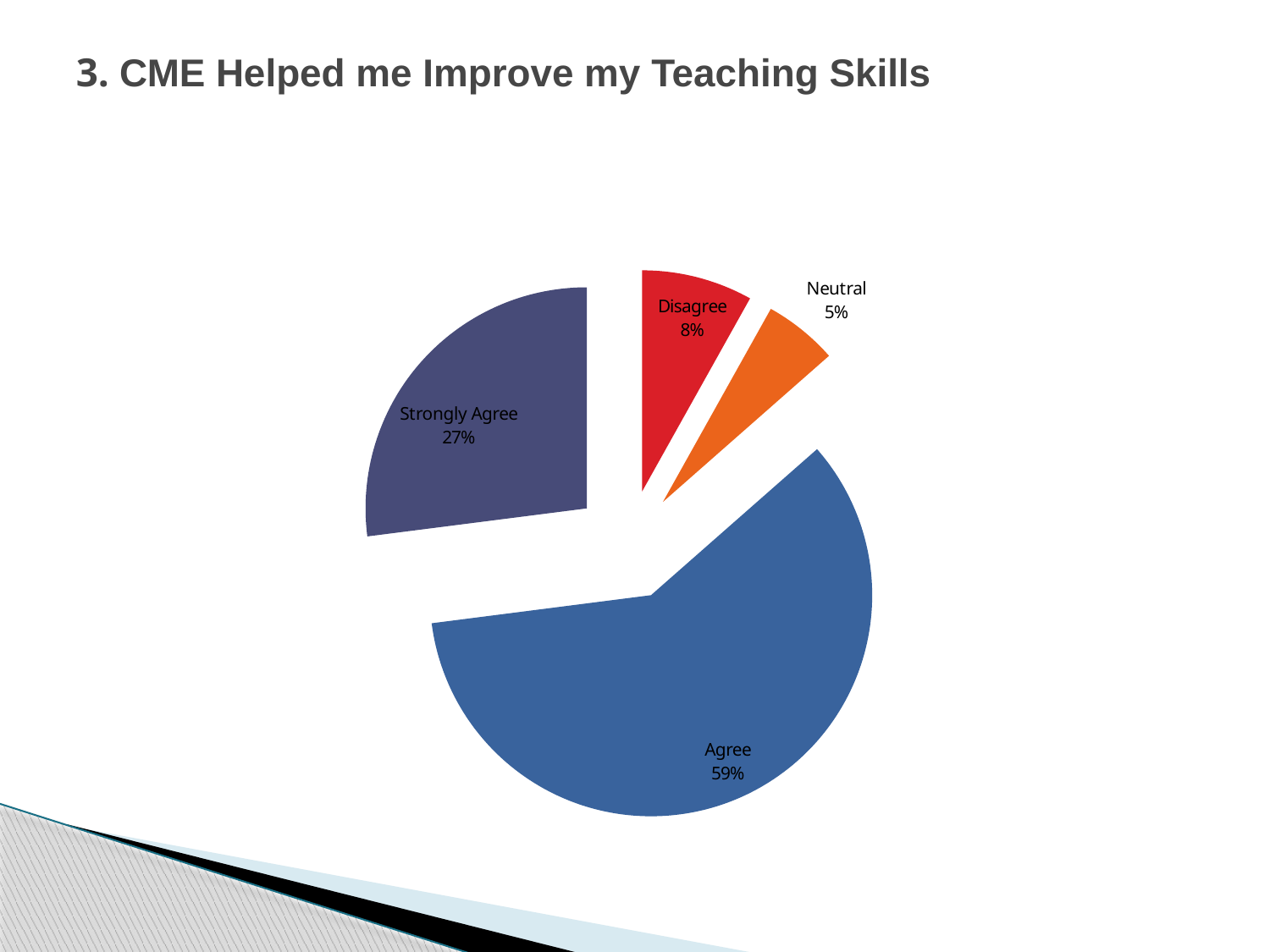
What is the difference in percentage points between Agree and Strongly Agree? 32 How many slices does the pie chart have? 4 What percentage of respondents chose Strongly Agree? 27% What percentage of respondents chose Disagree? 8% What kind of chart is shown on the slide? pie chart Which response category has the smallest share of the pie? Neutral Which response category has the largest share of the pie? Agree What percentage of respondents chose Agree? 59% What is the title of the slide containing the pie chart? 3. CME Helped me Improve my Teaching Skills What is the combined share of Agree and Strongly Agree? 86% What percentage of respondents chose Neutral? 5% Which is larger, the share for Disagree or the share for Neutral? Disagree